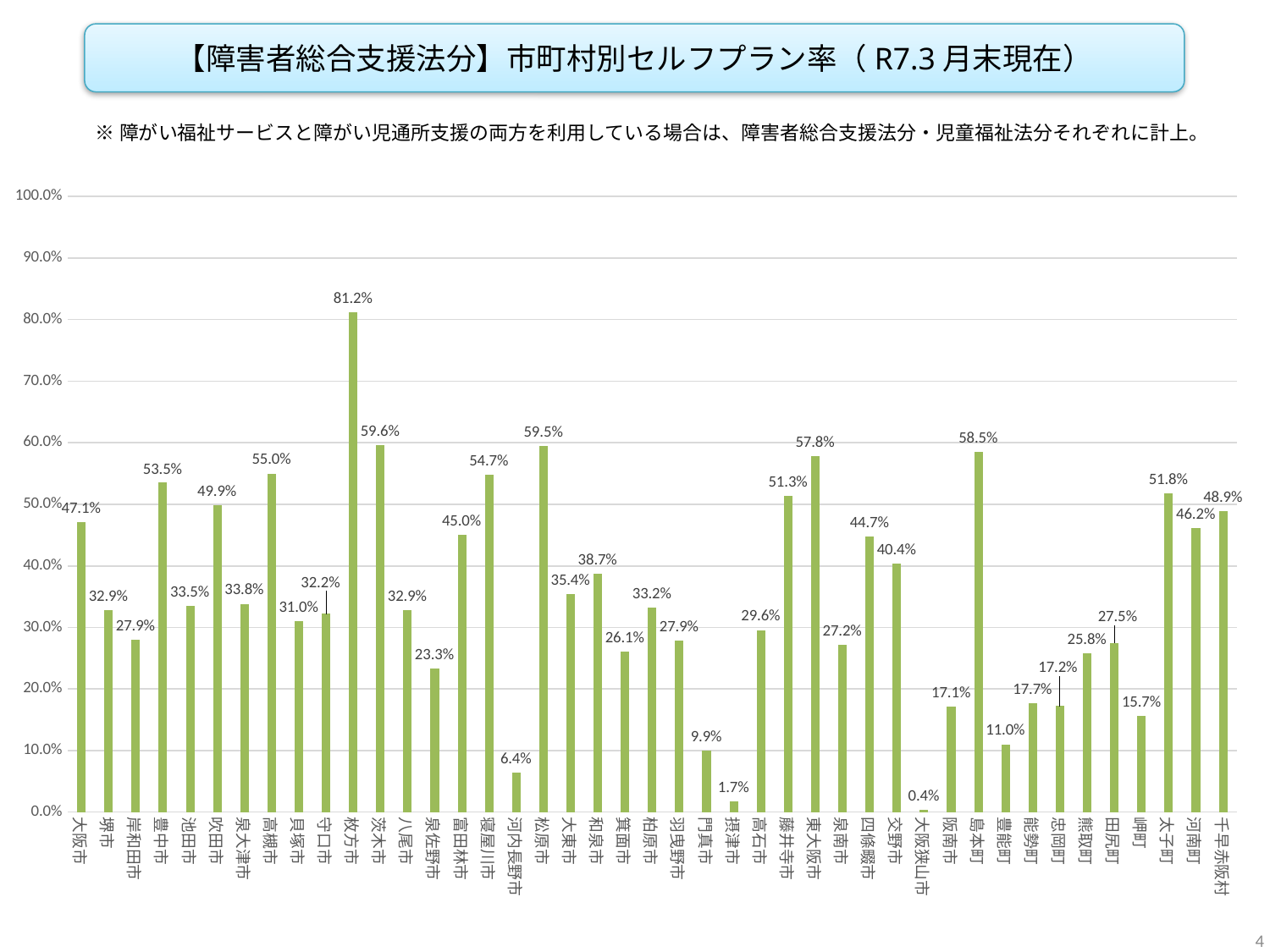
How many municipalities are shown on the x axis? 43 What is the self-plan rate for 摂津市? 1.7% What is the difference in percentage points between the self-plan rates of 枚方市 and 茨木市? 21.6 What kind of chart is shown on the slide? bar chart What is the self-plan rate for 大阪市? 47.1% Which municipality has the highest self-plan rate? 枚方市 Which municipality has the lowest self-plan rate? 大阪狭山市 What is the self-plan rate for 島本町? 58.5% What is the self-plan rate for 枚方市? 81.2% Is the value for 枚方市 greater or less than 80.0%? greater Which has a higher self-plan rate, 豊中市 or 吹田市? 豊中市 What is the difference in percentage points between the self-plan rates of 大阪市 and 堺市? 14.2